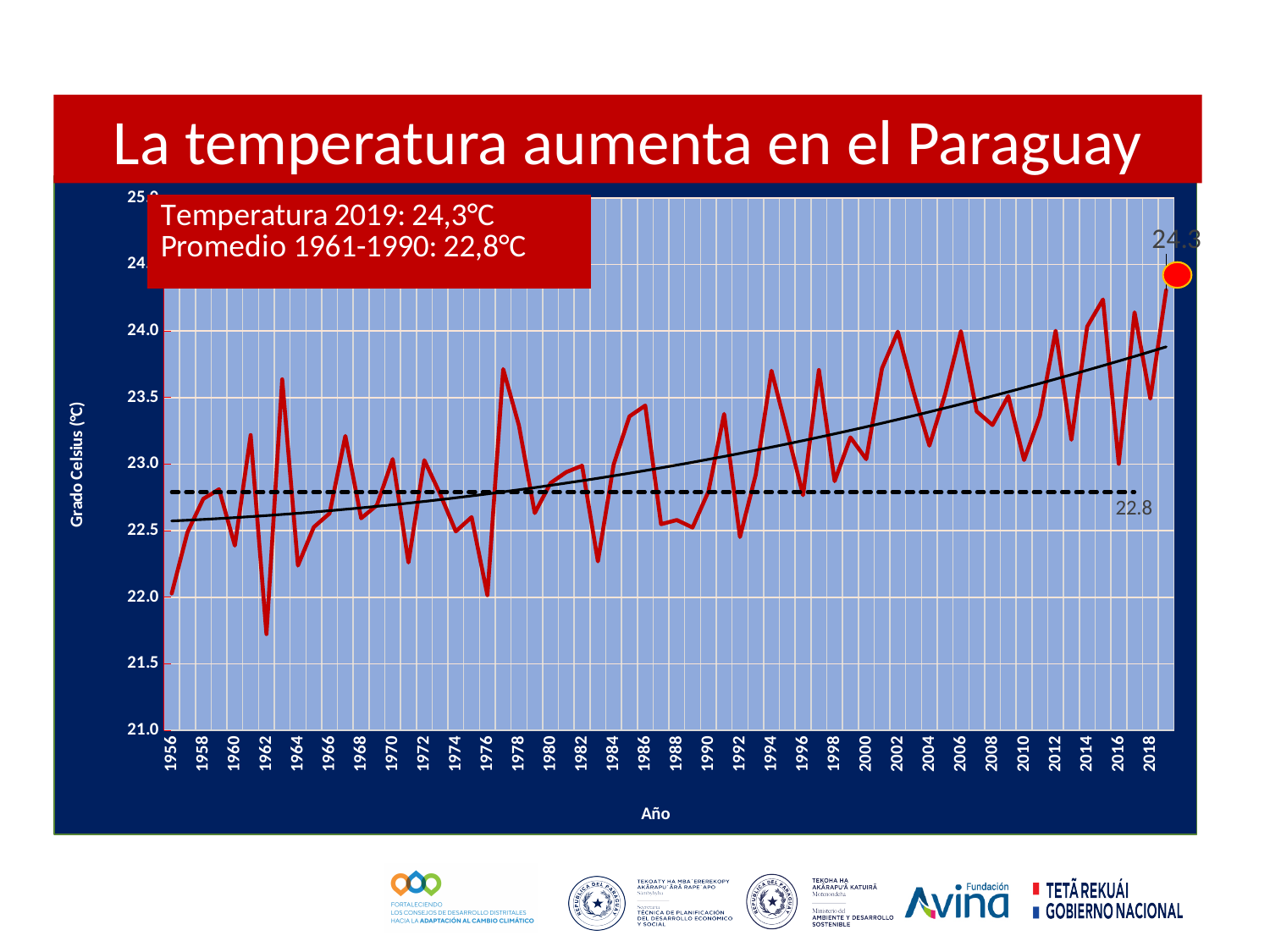
What value is labelled on the dashed horizontal line representing the 1961-1990 average? 22.8 What is the difference between the 2019 temperature (24.3) and the 1961-1990 average (22.8)? 1.5 Which year has the higher temperature, 1956 or 2019? 2019 Is the value for 1962 greater or less than 22.0? less What is the temperature value labelled for 2019? 24.3 Is the value for 2015 greater or less than 24.0? greater What is the title of the y axis? Grado Celsius (°C) Is the value for 1956 greater or less than 22.5? less Which year has the lowest temperature on the chart? 1962 What kind of chart is shown on the slide? line chart Which year has the highest temperature on the chart? 2019 Overall, do the temperature values rise or fall from 1956 to 2019? rise